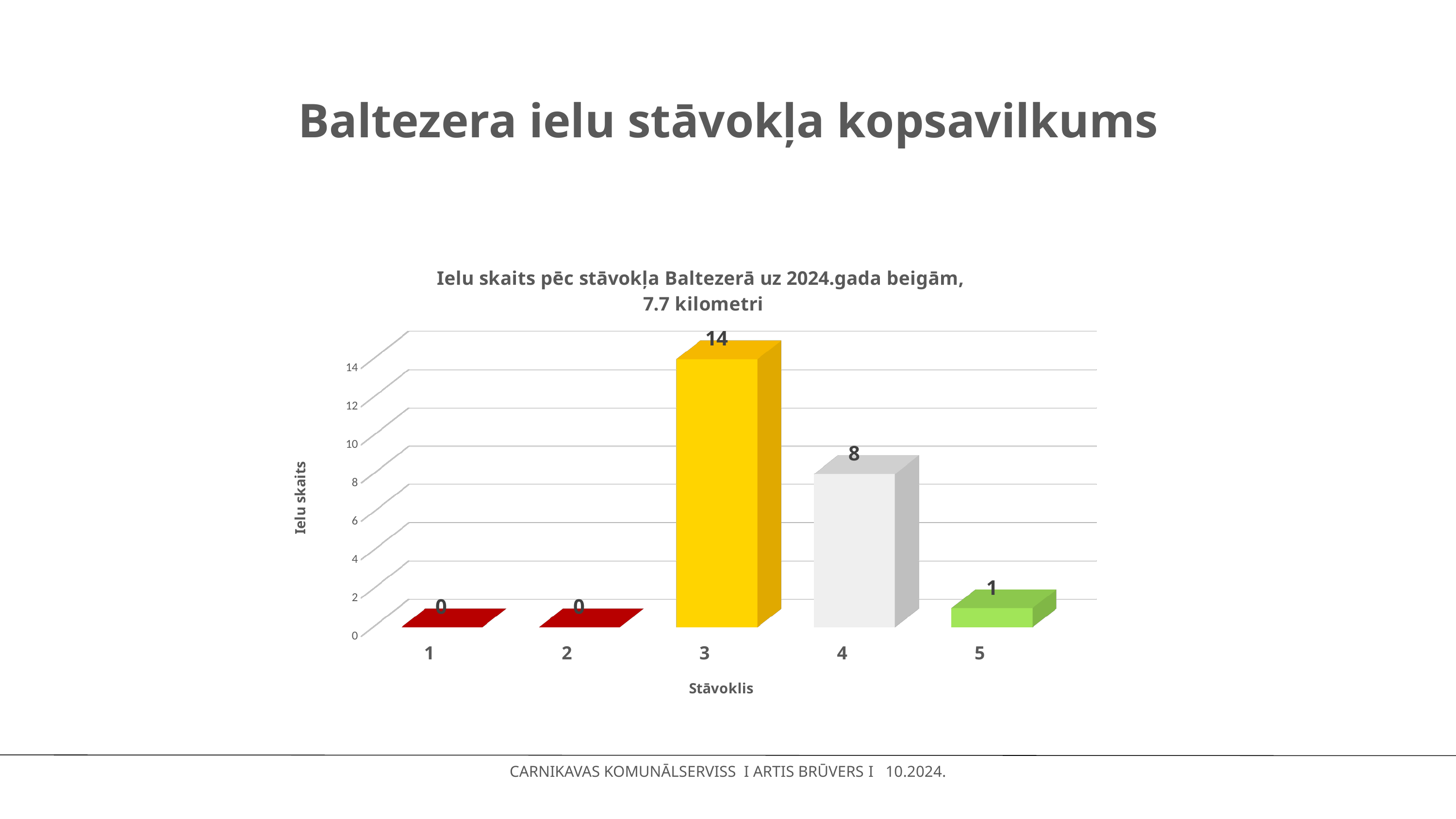
What is the difference between the values for categories 3 and 4? 6 What is the value for category 3? 14 What is the label of the y axis? Ielu skaits Is the value for category 3 greater or less than 10? greater Which is larger, the value for category 4 or the value for category 5? 4 What is the value for category 5? 1 What is the value for category 1? 0 What kind of chart is shown on the slide? bar chart What is the value for category 4? 8 What is the label of the x axis? Stāvoklis Which category has the highest value? 3 How many categories are shown on the x axis? 5